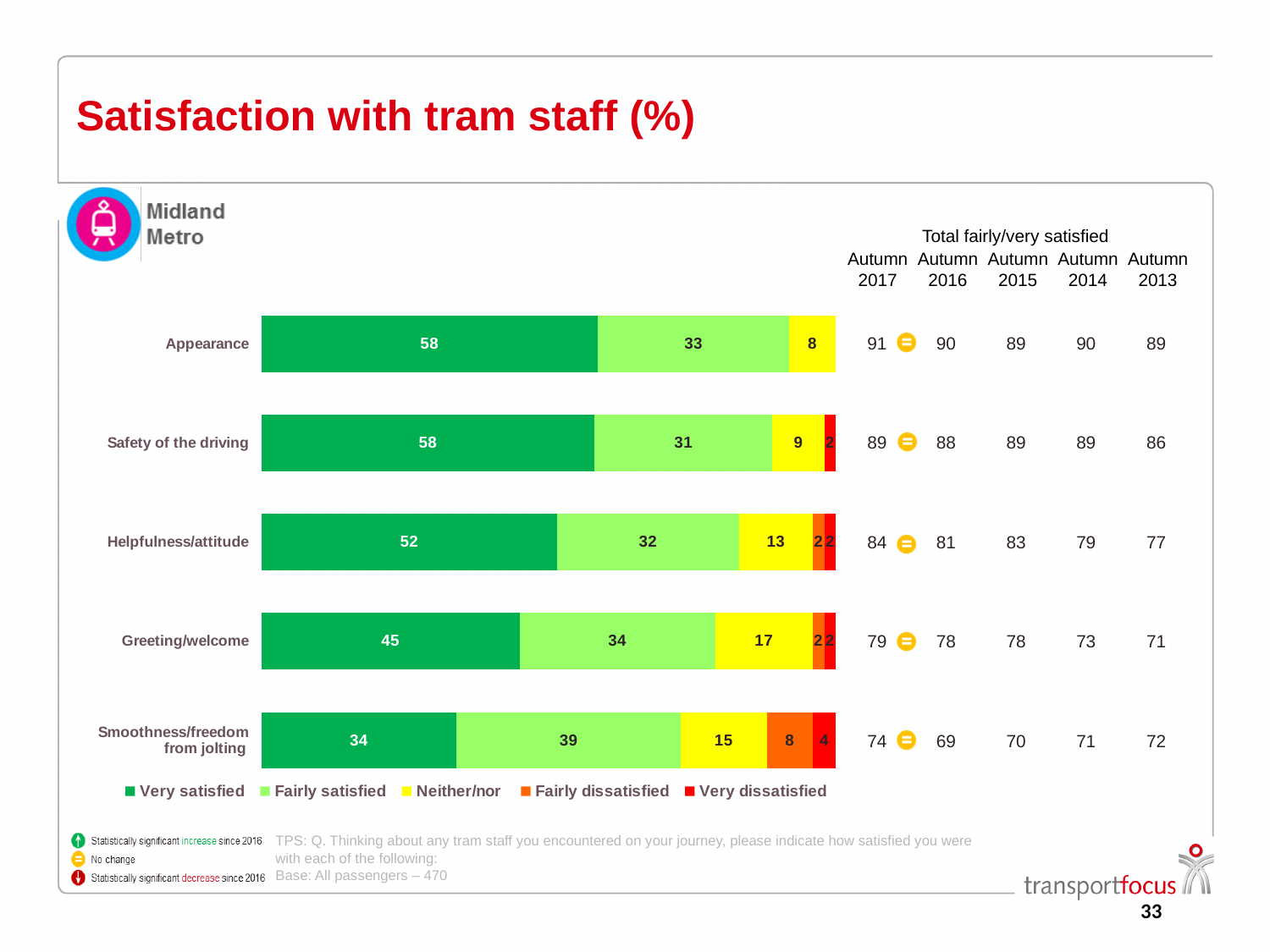
Which category has the highest Neither/nor value? Greeting/welcome What is the Very dissatisfied value for Smoothness/freedom from jolting? 4 What is the Fairly satisfied value for Smoothness/freedom from jolting? 39 Which category has the lowest Very satisfied value? Smoothness/freedom from jolting What kind of chart is shown on the slide? Stacked bar chart Which has the larger Fairly satisfied value, Greeting/welcome or Helpfulness/attitude? Greeting/welcome What is the Neither/nor value for Greeting/welcome? 17 How many series does the legend list? 5 What is the difference between the Very satisfied values for Appearance and Smoothness/freedom from jolting? 24 What is the Fairly dissatisfied value for Smoothness/freedom from jolting? 8 How many categories are shown in the chart? 5 What is the Very satisfied value for Appearance? 58